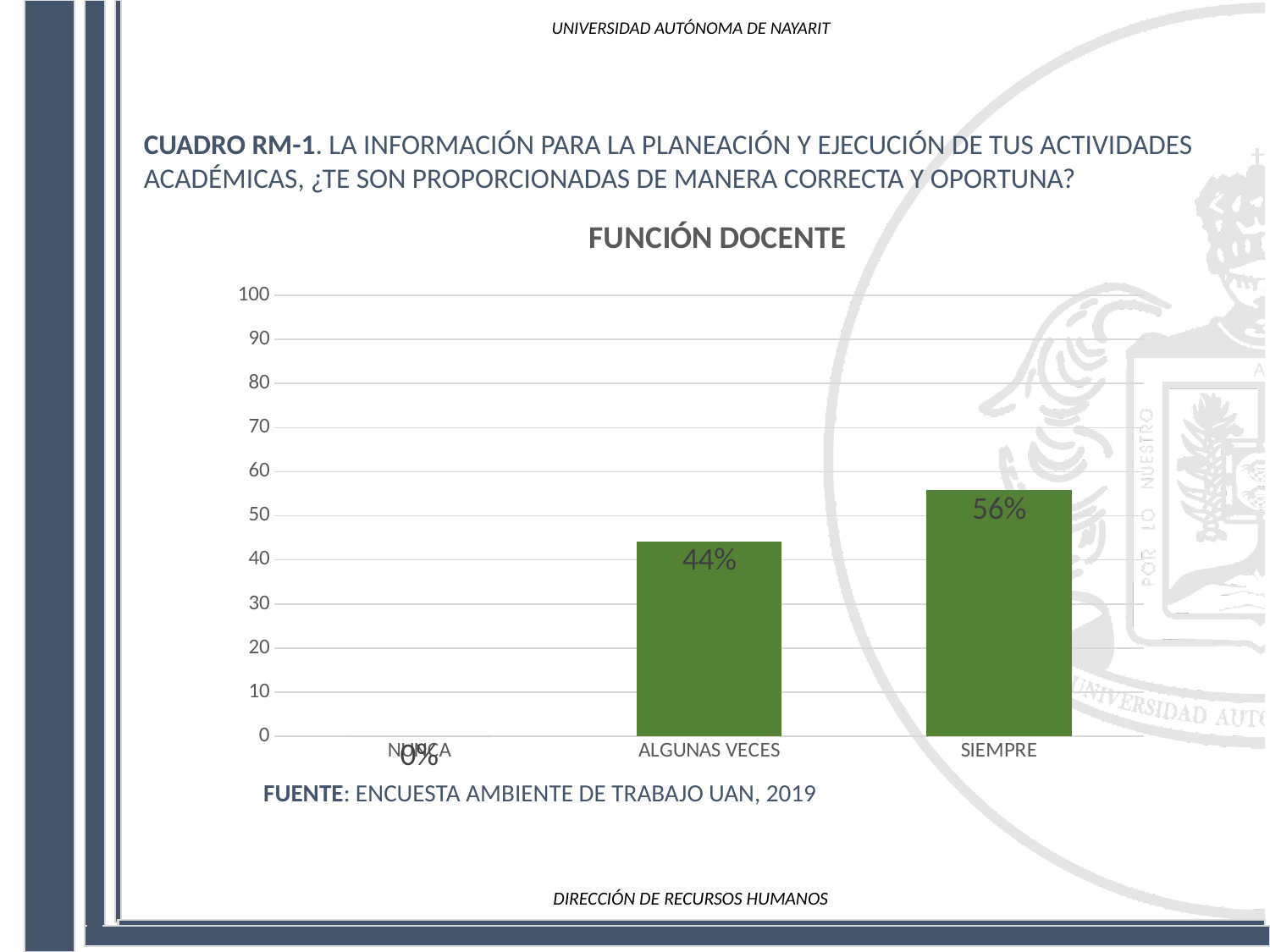
What is the value for ALGUNAS VECES? 44% How many categories are shown on the x axis? 3 Which category has the highest value? SIEMPRE Which is larger, the value for ALGUNAS VECES or the value for SIEMPRE? SIEMPRE What is the value for NUNCA? 0% Is the value for SIEMPRE greater or less than 50? greater What is the title of the chart? FUNCIÓN DOCENTE What is the difference between the values for SIEMPRE and ALGUNAS VECES? 12% Which category has the lowest value? NUNCA What kind of chart is shown? bar chart Is the value for ALGUNAS VECES greater or less than 50? less What is the value for SIEMPRE? 56%